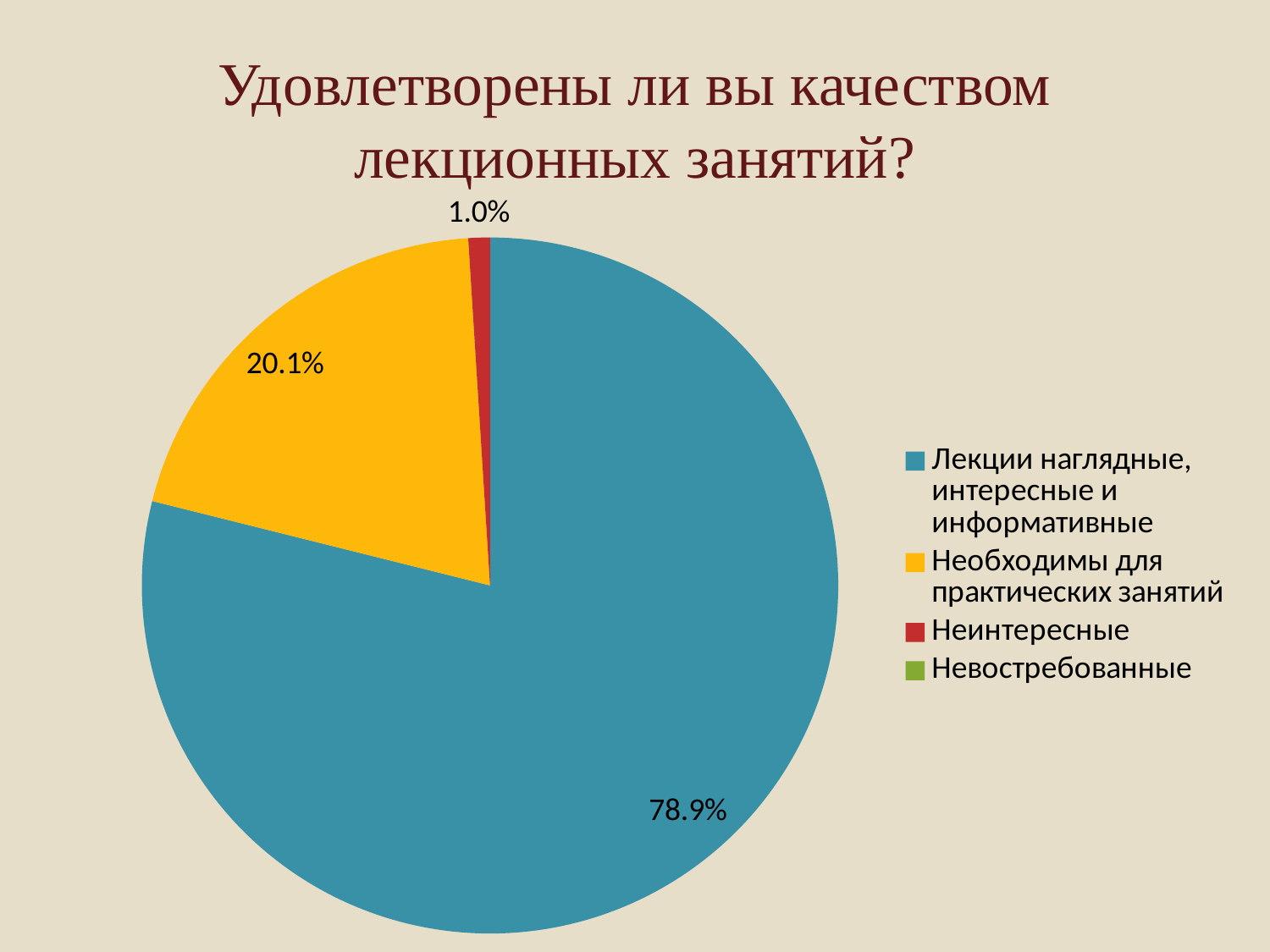
What value is shown for the 'Неинтересные' slice? 1.0% What colour is used for the 'Неинтересные' category in the legend? Red What is the difference in percentage points between the 'Лекции наглядные, интересные и информативные' slice and the 'Необходимы для практических занятий' slice? 58.8 What is the title of the slide? Удовлетворены ли вы качеством лекционных занятий? Which category has the largest slice of the pie? Лекции наглядные, интересные и информативные How many categories does the legend list? 4 What kind of chart is shown on the slide? Pie chart Which is larger: the share for 'Необходимы для практических занятий' or the share for 'Неинтересные'? Необходимы для практических занятий What share of the pie corresponds to 'Необходимы для практических занятий'? 20.1% Of the slices with a printed value label, which category has the smallest share? Неинтересные What percentage of respondents said the lectures are visual, interesting and informative (Лекции наглядные, интересные и информативные)? 78.9% What is the difference in percentage points between the 'Необходимы для практических занятий' slice and the 'Неинтересные' slice? 19.1